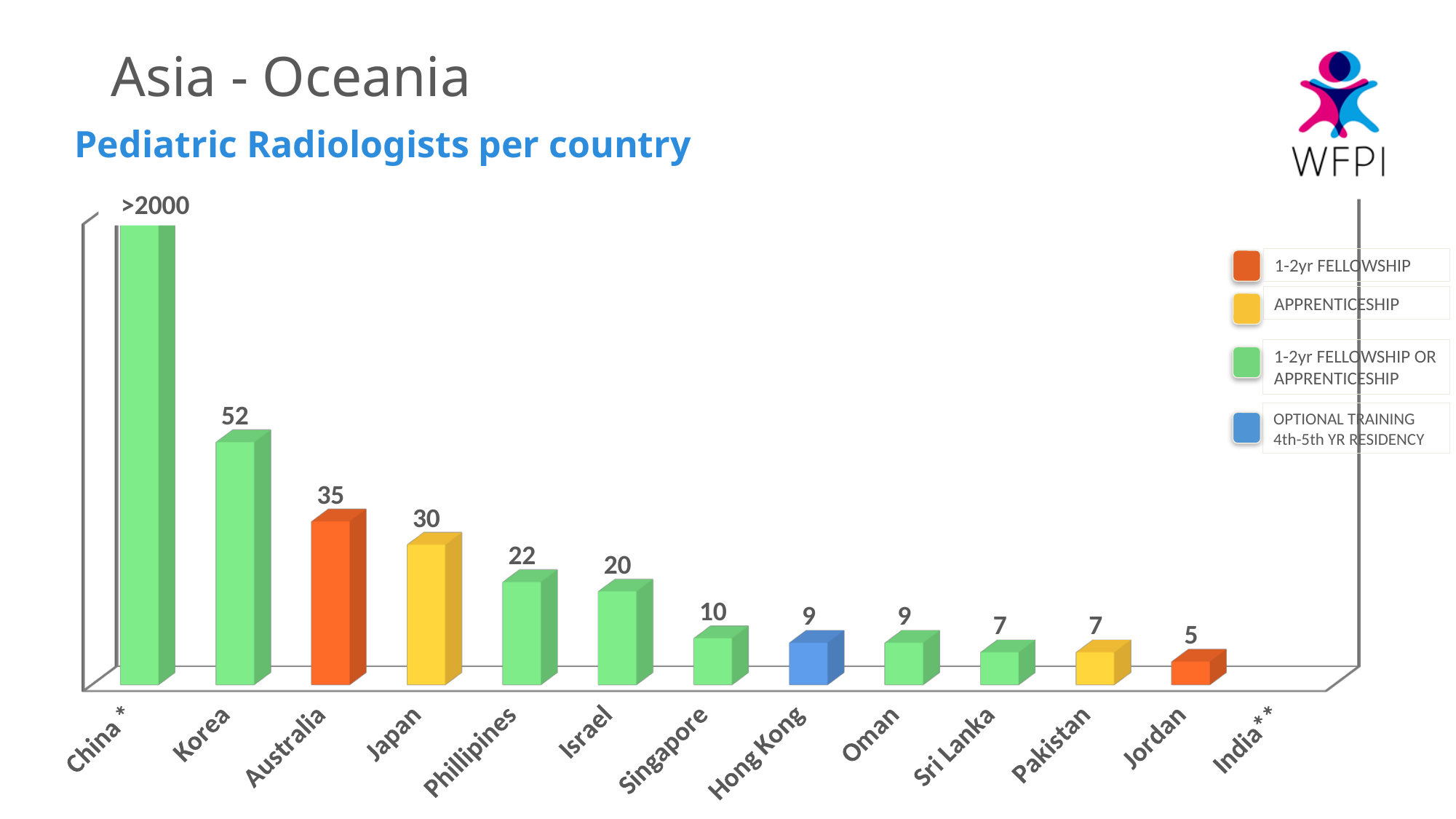
What value is shown for Israel? 20 According to the legend, what does the blue colour of the Hong Kong bar represent? OPTIONAL TRAINING 4th-5th YR RESIDENCY What value is shown for Japan? 30 What kind of chart is shown? Bar chart What value is shown for China *? >2000 What value is shown for Korea? 52 Which is larger, the value for Phillipines or the value for Singapore? Phillipines What value is shown for Australia? 35 How many entries does the legend list? 4 Among the countries with a plotted bar, which has the lowest value? Jordan What is the difference between the values for Korea and Australia? 17 Which country has the highest value? China *